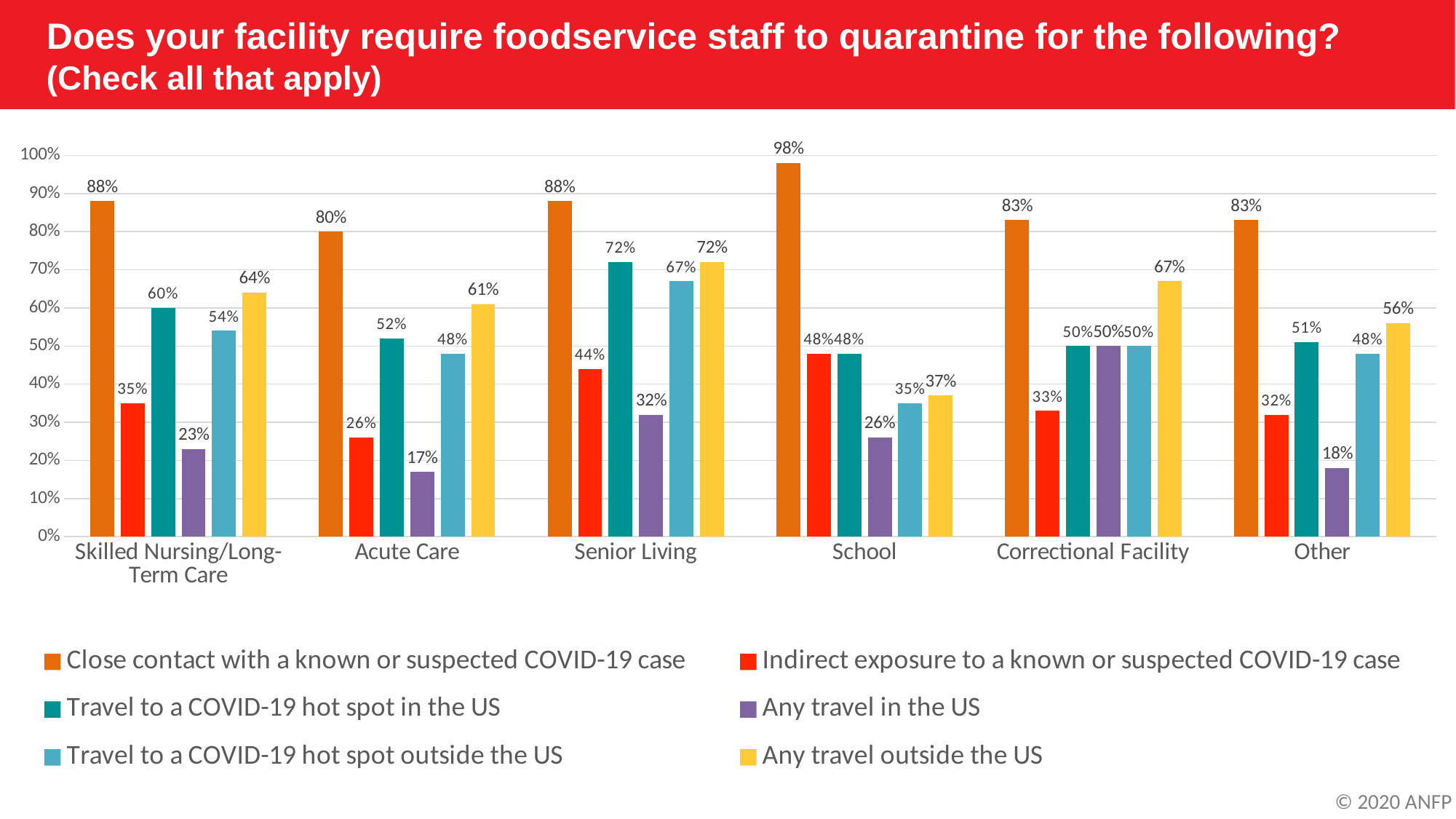
What is the difference between the 'Travel to a COVID-19 hot spot in the US' values for Senior Living and School? 24% Is the value for 'Indirect exposure to a known or suspected COVID-19 case' in the Other category greater or less than 40%? less What kind of chart is shown on the slide? Bar chart What is the value for 'Any travel outside the US' for Correctional Facility? 67% What is the value for 'Any travel in the US' in the Senior Living category? 32% Which facility type has the lowest value for 'Any travel in the US'? Acute Care Which is larger for Skilled Nursing/Long-Term Care: 'Travel to a COVID-19 hot spot outside the US' or 'Any travel outside the US'? Any travel outside the US How many facility types are shown on the x axis? 6 Which facility type has the highest value for close contact with a known or suspected COVID-19 case? School Which colour represents 'Any travel in the US' in the legend? Purple How many series does the legend list? 6 What percentage of Acute Care facilities require quarantine for close contact with a known or suspected COVID-19 case? 80%